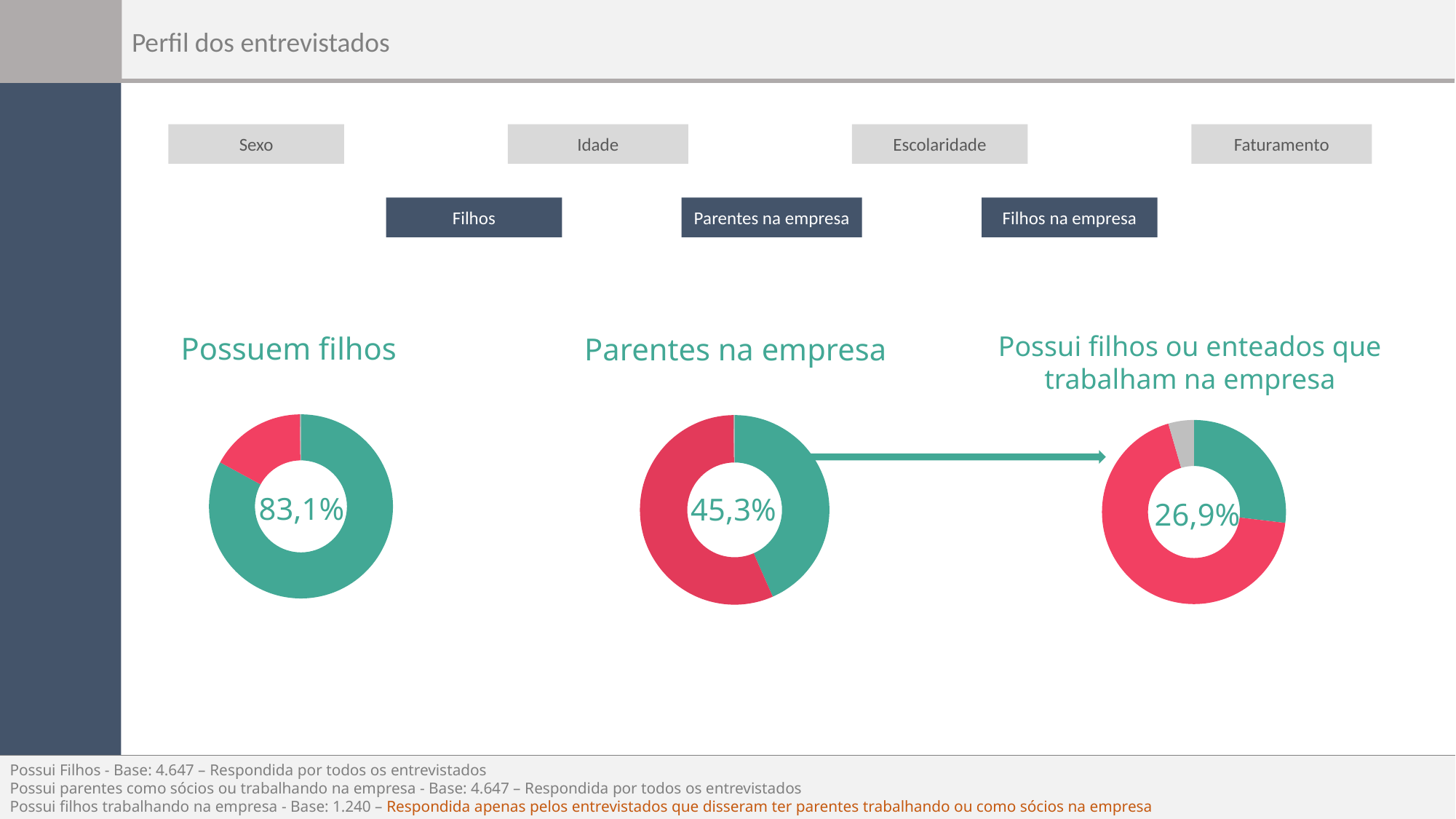
Which is larger: the percentage in the 'Parentes na empresa' chart or the percentage in the 'Possui filhos ou enteados que trabalham na empresa' chart? Parentes na empresa What is the difference in percentage points between the value in the 'Parentes na empresa' chart and the value in the 'Possui filhos ou enteados que trabalham na empresa' chart? 18,4 How many slices does the 'Possui filhos ou enteados que trabalham na empresa' donut chart have? 3 What type of chart is used for 'Possuem filhos'? Donut (pie) chart How many donut charts are shown on the slide? 3 Which of the three donut charts shows the lowest percentage value? Possui filhos ou enteados que trabalham na empresa In the 'Possuem filhos' chart, which colour is the slice that represents the 83,1% value? Green In the 'Possui filhos ou enteados que trabalham na empresa' chart, what percentage is shown in the centre of the donut? 26,9% Which of the three donut charts shows the highest percentage value? Possuem filhos In the 'Possuem filhos' chart, what percentage is shown in the centre of the donut? 83,1% In the 'Parentes na empresa' chart, what percentage is shown in the centre of the donut? 45,3% What is the difference in percentage points between the value in the 'Possuem filhos' chart and the value in the 'Parentes na empresa' chart? 37,8